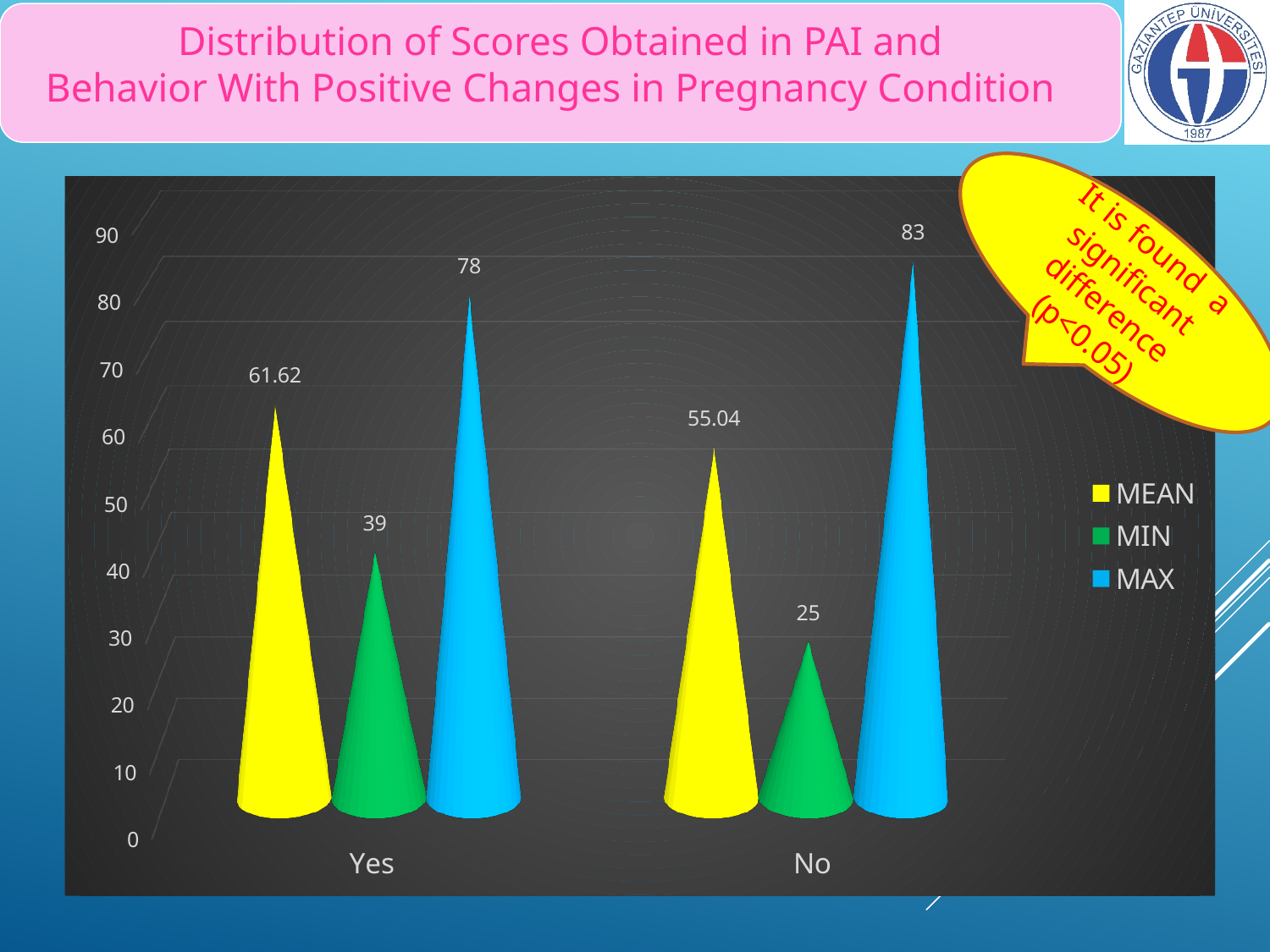
Which category has the higher MAX value, Yes or No? No What is the MEAN value for the Yes category? 61.62 What is the MIN value for the Yes category? 39 What is the MAX value for the No category? 83 Which category has the higher MIN value, Yes or No? Yes What kind of chart is shown on the slide? Bar chart What is the difference between the MAX values for No and Yes? 5 How many categories are shown on the x axis? 2 Which colour represents the MAX series in the legend? Blue How many series does the legend list? 3 What is the difference between the MIN values for Yes and No? 14 What is the MEAN value for the No category? 55.04